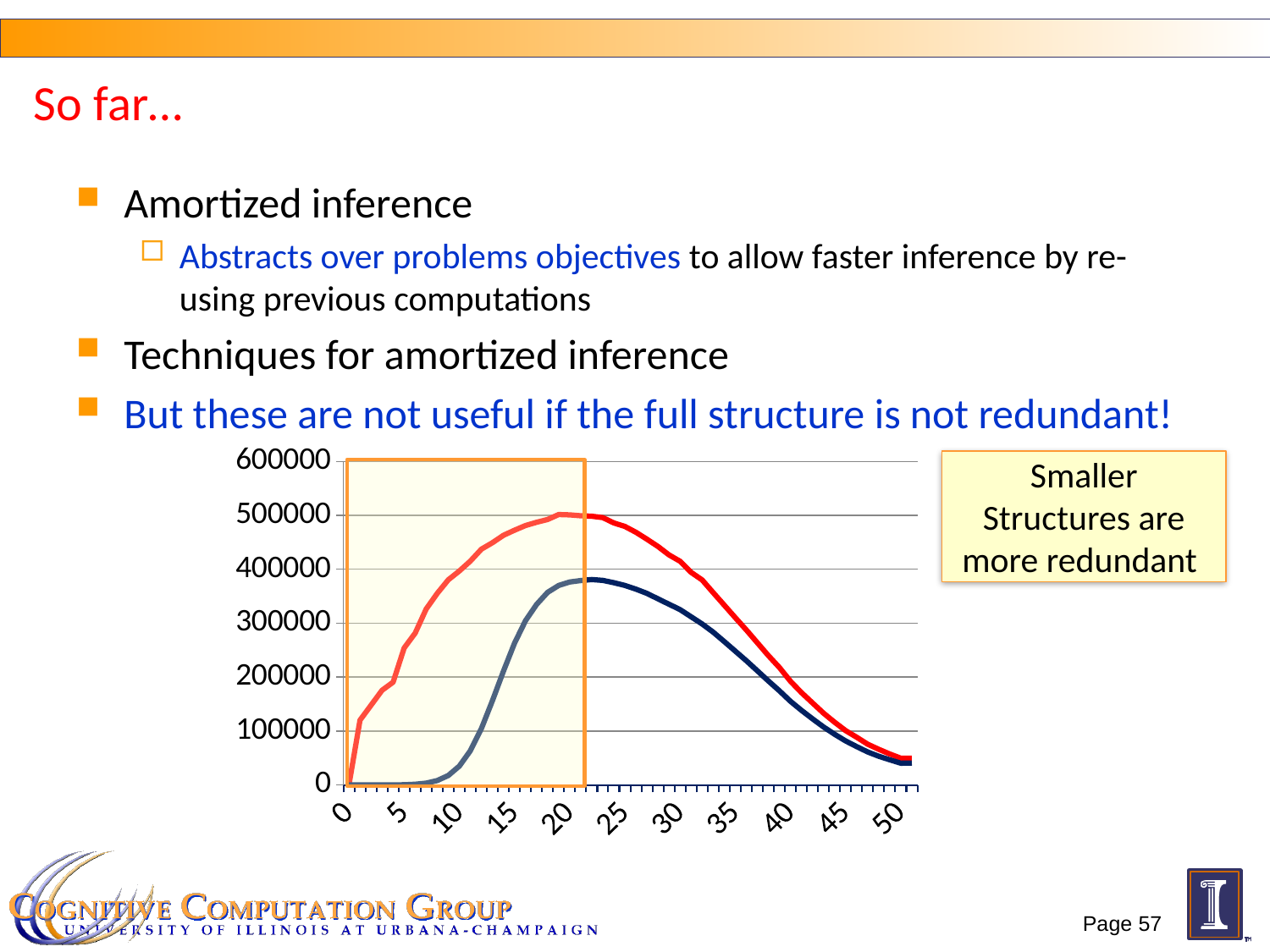
Which line reaches the higher peak, the red line or the dark blue line? the red line What is the largest value labelled on the chart's x axis? 50 Is the peak value of the dark blue line greater or less than 400000? less At x = 10, which line has the larger value, the red line or the dark blue line? the red line Is the peak value of the red line greater or less than 400000? greater Is the value of the red line at x = 10 greater or less than 300000? greater How many lines are plotted on the chart? 2 What kind of chart is shown on the slide? line chart What is the highest value shown on the chart's y axis? 600000 Does the red line rise or fall between x = 25 and x = 50? fall